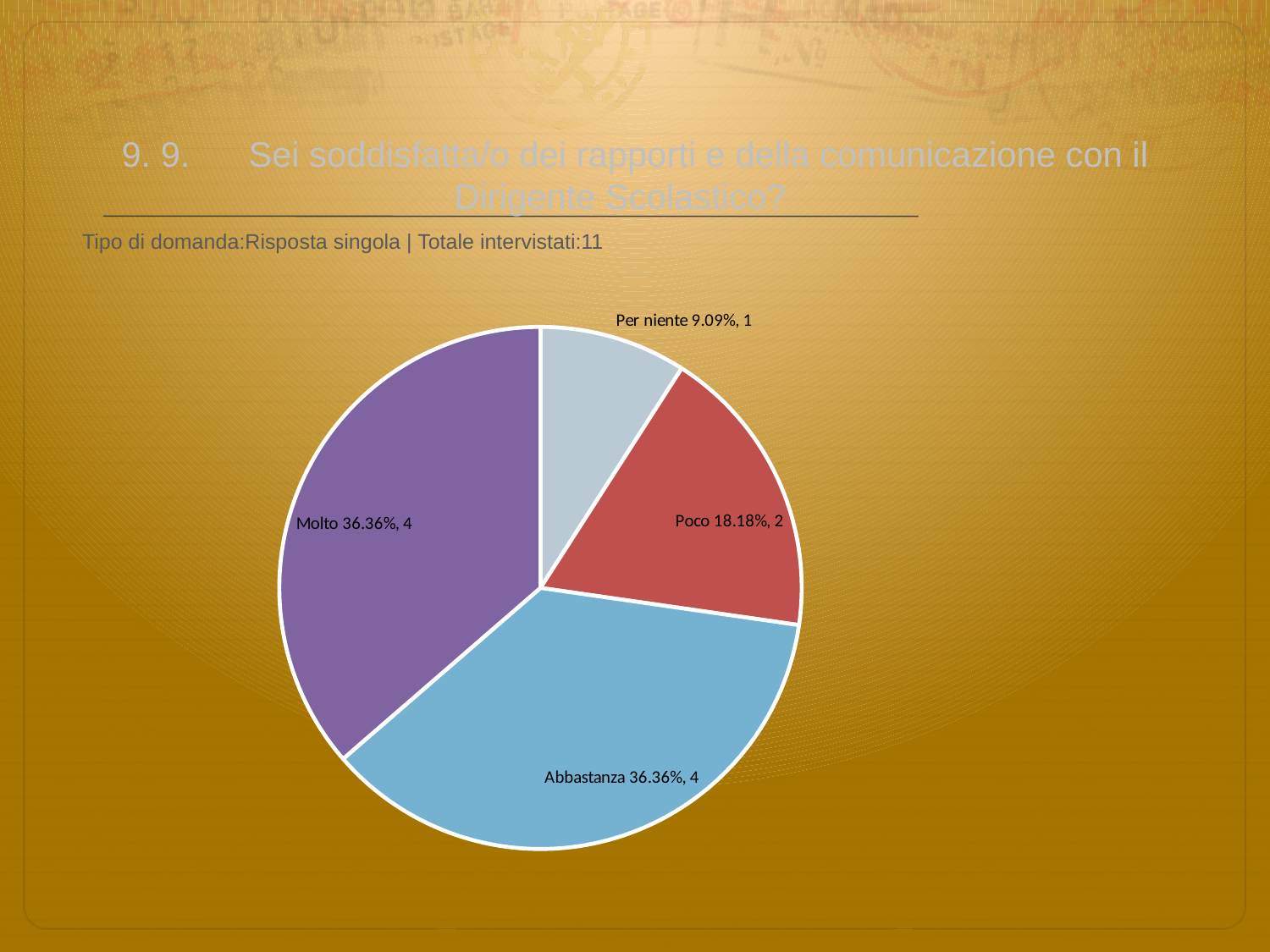
Which response has the larger share: "Poco" or "Per niente"? Poco How many respondents answered "Abbastanza"? 4 Which response has the larger share: "Abbastanza" or "Poco"? Abbastanza How many slices does the pie chart have? 4 How many respondents answered "Per niente"? 1 What percentage of respondents answered "Poco"? 18.18% What is the share of the pie for "Abbastanza"? 36.36% According to the text above the chart, what is the total number of respondents (Totale intervistati)? 11 What percentage of respondents answered "Molto"? 36.36% What kind of chart is shown on the slide? pie chart What is the difference in the number of respondents between "Molto" and "Poco"? 2 Which response has the smallest share of the pie? Per niente